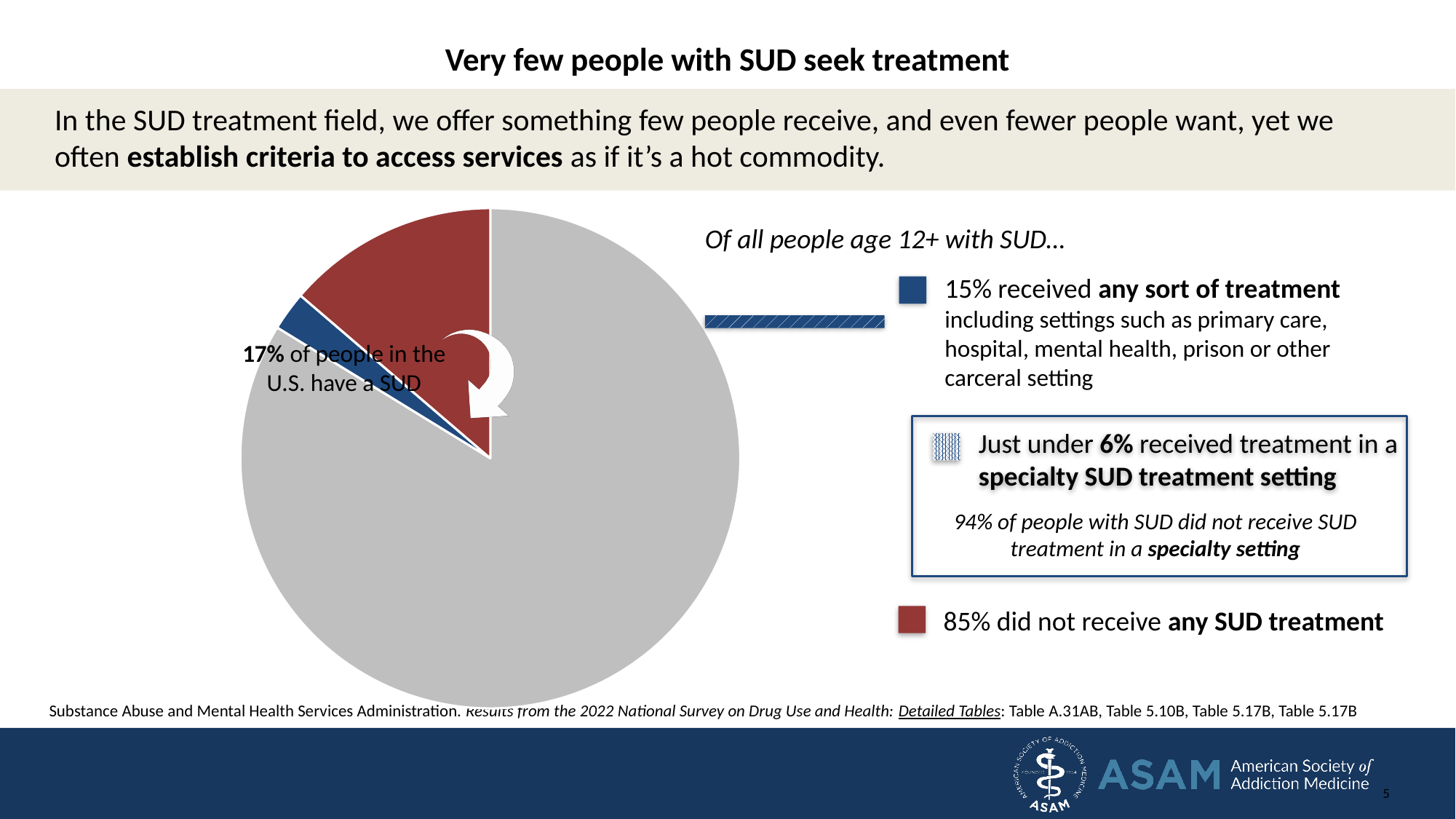
What percentage of people with SUD did not receive SUD treatment in a specialty setting? 94% Which slice of the pie chart is the smallest? the blue slice (received any sort of treatment) How many colored slices does the pie chart have? 3 Which is larger among people with SUD: the share that received any sort of treatment or the share that did not receive any SUD treatment? did not receive any SUD treatment According to the pie chart, what percentage of people in the U.S. have a SUD? 17% Of all people age 12+ with SUD, what percentage received any sort of treatment? 15% What kind of chart is shown on the slide? pie chart Of all people age 12+ with SUD, what percentage did not receive any SUD treatment? 85% What does the blue color in the pie chart represent? 15% received any sort of treatment What is the difference between the percentage of people with SUD who did not receive any SUD treatment and the percentage who received any sort of treatment? 70% Which slice of the pie chart is the largest? the gray slice (people without a SUD) What does the red color in the pie chart represent? 85% did not receive any SUD treatment